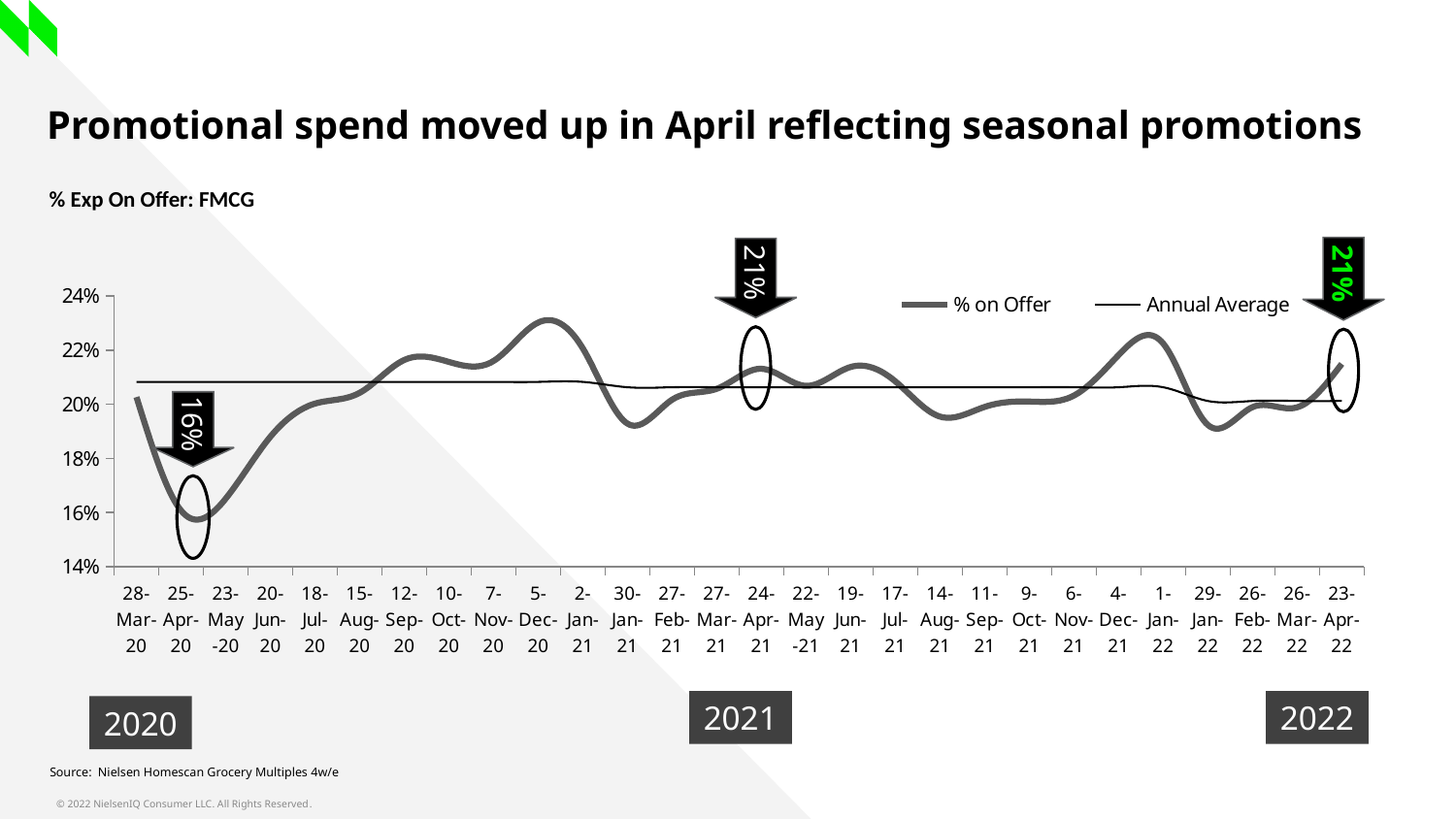
What is the % on Offer value labelled at 24-Apr-21? 21% At which date does the % on Offer line reach its lowest point? 25-Apr-20 What is the % on Offer value labelled at 25-Apr-20? 16% How many series does the chart legend list? 2 What is the title of the chart? % Exp On Offer: FMCG What is the % on Offer value labelled at 23-Apr-22? 21% What is the difference between the labelled % on Offer values at 24-Apr-21 and 25-Apr-20? 5 percentage points Which is larger, the % on Offer value at 25-Apr-20 or at 24-Apr-21? 24-Apr-21 Is the % on Offer value at 14-Aug-21 greater or less than 20%? less At which date does the % on Offer line reach its highest point? 5-Dec-20 What kind of chart is shown on the slide? line chart Is the % on Offer value at 5-Dec-20 greater or less than 22%? greater